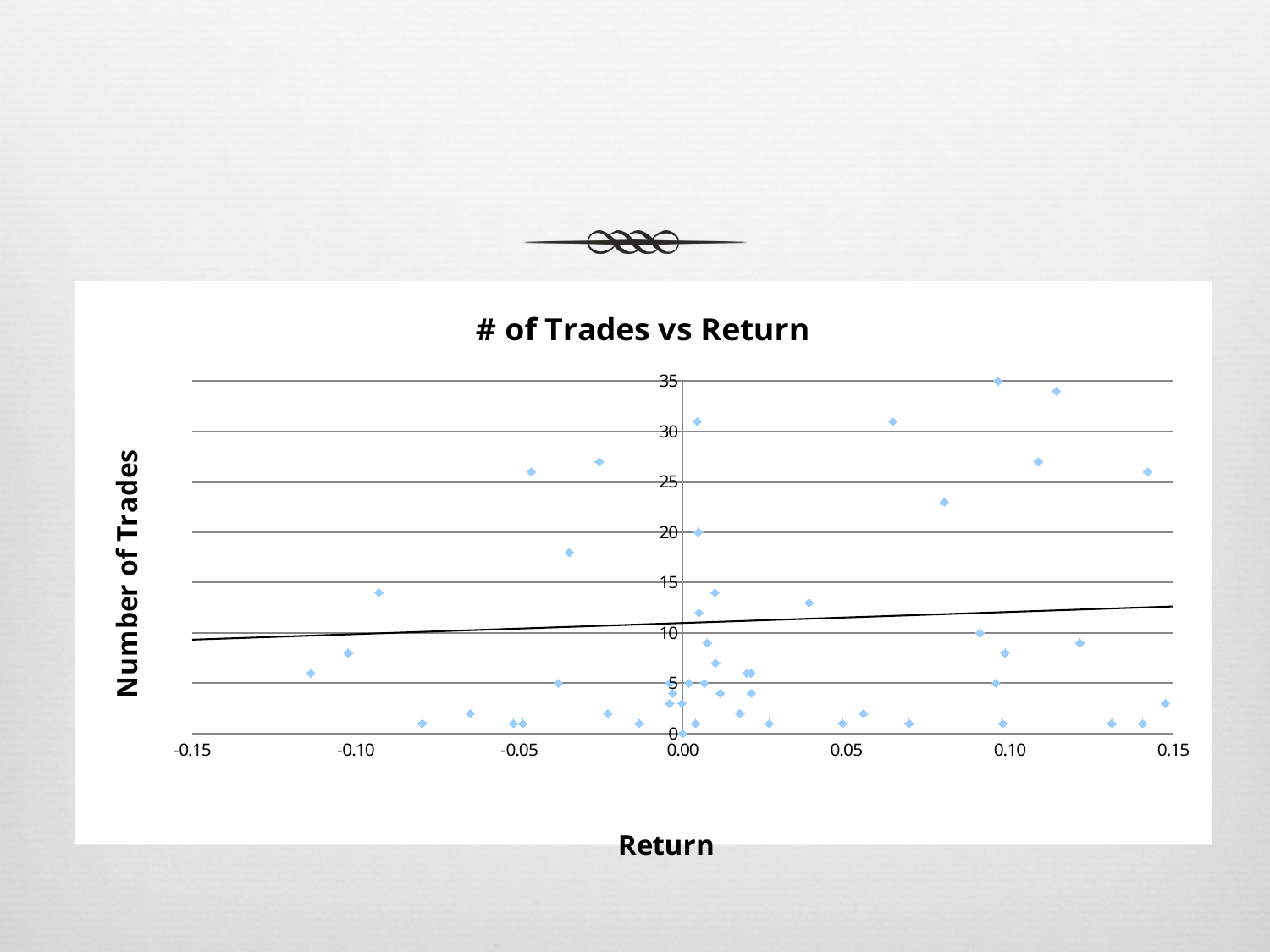
What kind of chart is shown on the slide? scatter chart What is the title of the chart? # of Trades vs Return Is the trendline value at a Return of 0.15 greater or less than 20 trades? less Is the trendline value at a Return of 0.00 greater or less than 15 trades? less Is the trendline value at a Return of -0.15 greater or less than 5 trades? greater What is the label on the vertical axis of the chart? Number of Trades Does the trendline in the chart rise or fall as Return increases along the x axis? rises